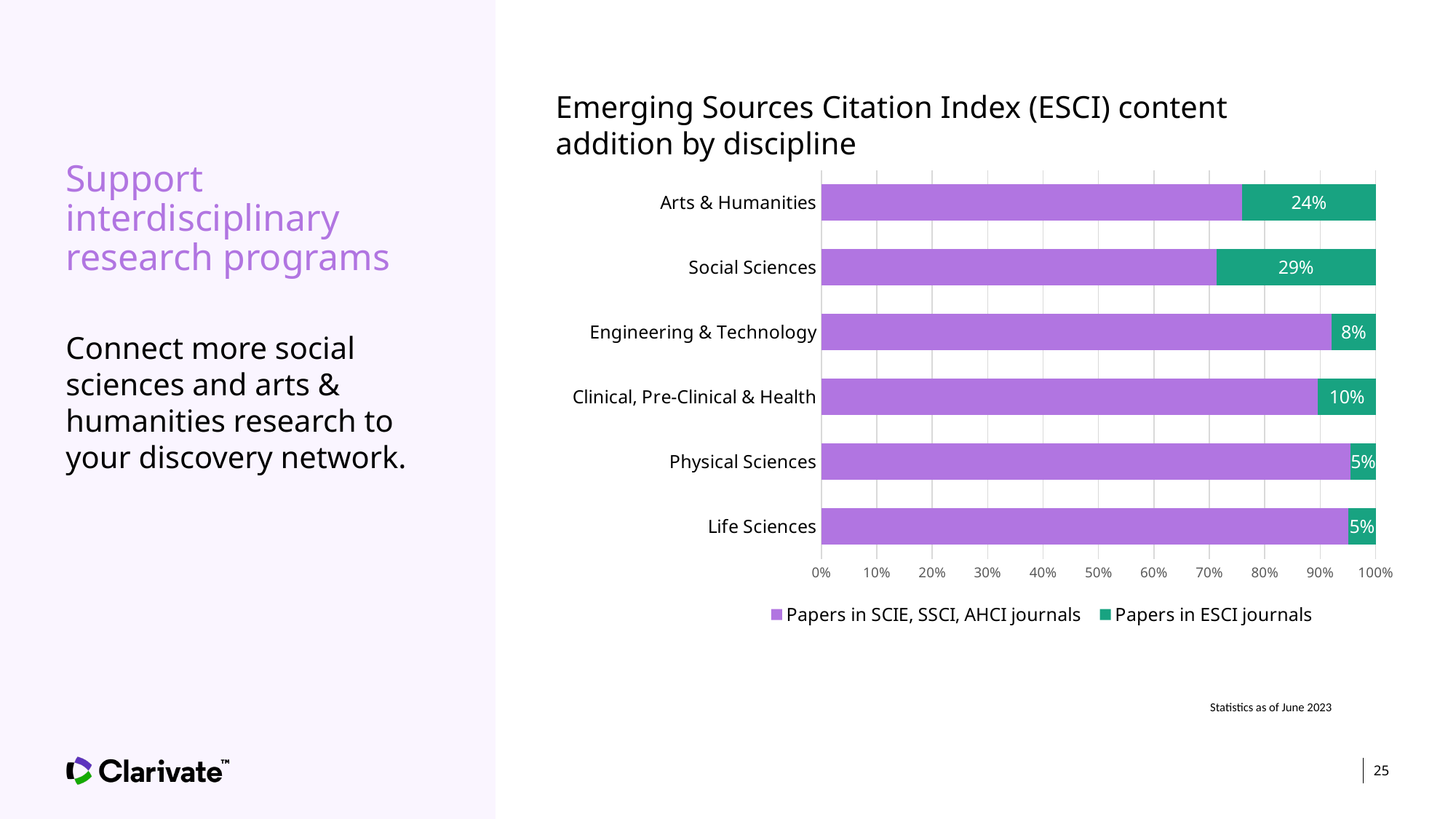
How many disciplines are shown in the chart? 6 How many series does the legend list? 2 What is the title of the chart? Emerging Sources Citation Index (ESCI) content addition by discipline What is the share of papers in ESCI journals for Clinical, Pre-Clinical & Health? 10% Which discipline has the highest share of papers in ESCI journals? Social Sciences What kind of chart is shown on the slide? Stacked bar chart Is the share of papers in SCIE, SSCI, AHCI journals for Arts & Humanities greater or less than 70%? greater Which has a larger share of papers in ESCI journals, Clinical, Pre-Clinical & Health or Engineering & Technology? Clinical, Pre-Clinical & Health What is the difference between the ESCI journal shares for Social Sciences and Arts & Humanities? 5% What is the share of papers in ESCI journals for Arts & Humanities? 24% What is the share of papers in ESCI journals for Engineering & Technology? 8% What is the share of papers in ESCI journals for Social Sciences? 29%